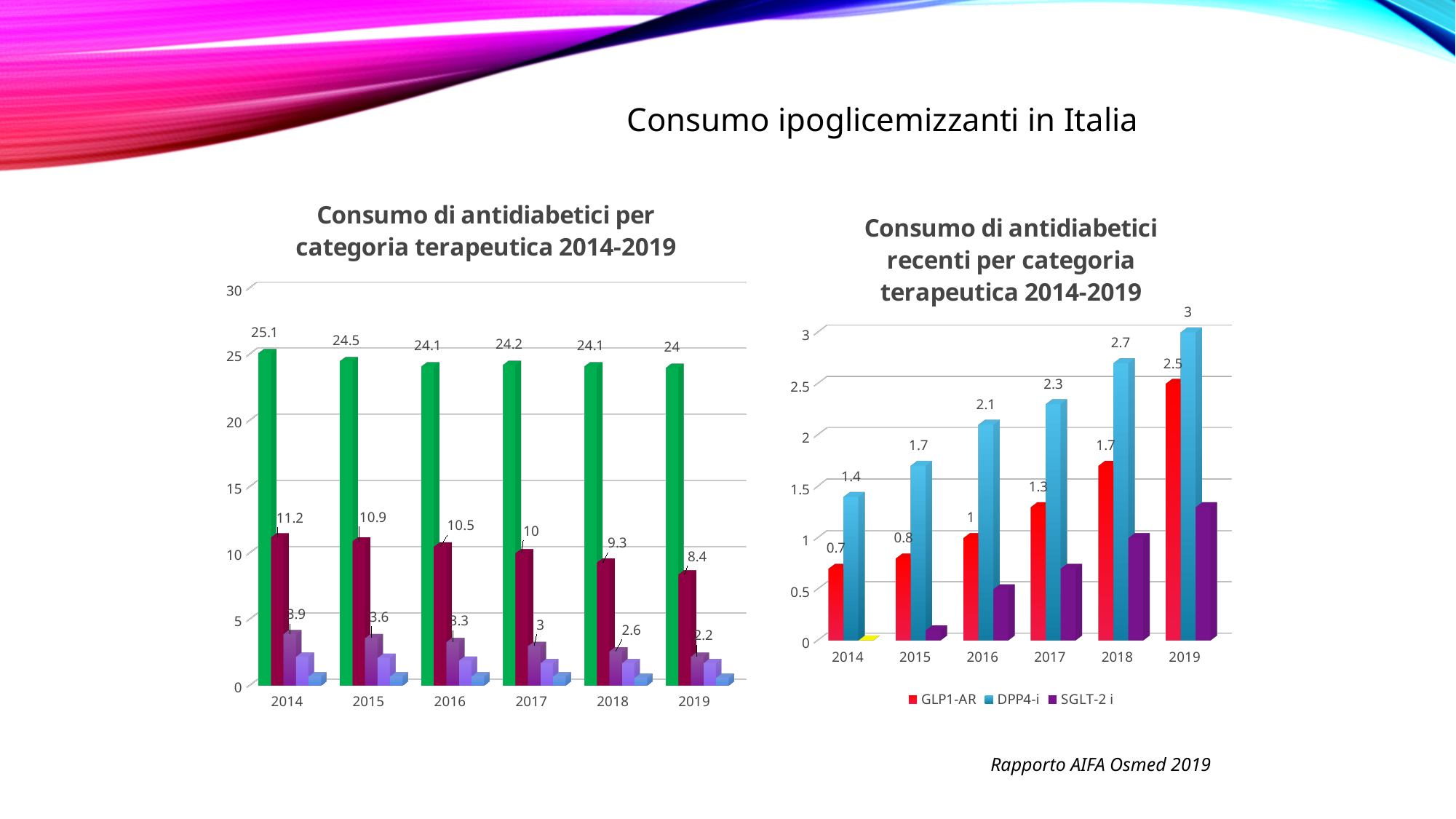
In the chart 'Consumo di antidiabetici recenti per categoria terapeutica 2014-2019', do the DPP4-i values rise or fall from 2014 to 2019? rise In the chart 'Consumo di antidiabetici per categoria terapeutica 2014-2019', what is the value of the dark red bar in 2019? 8.4 In the chart 'Consumo di antidiabetici per categoria terapeutica 2014-2019', what is the difference between the dark red bar values in 2014 and 2019? 2.8 What kind of chart is 'Consumo di antidiabetici per categoria terapeutica 2014-2019'? bar chart In the chart 'Consumo di antidiabetici recenti per categoria terapeutica 2014-2019', what is the value for DPP4-i in 2019? 3 In the chart 'Consumo di antidiabetici recenti per categoria terapeutica 2014-2019', what is the difference between the DPP4-i and GLP1-AR values in 2014? 0.7 In the chart 'Consumo di antidiabetici per categoria terapeutica 2014-2019', what is the value of the green bar in 2014? 25.1 In the chart 'Consumo di antidiabetici recenti per categoria terapeutica 2014-2019', how many series does the legend list? 3 In the chart 'Consumo di antidiabetici recenti per categoria terapeutica 2014-2019', what is the value for GLP1-AR in 2017? 1.3 In the chart 'Consumo di antidiabetici recenti per categoria terapeutica 2014-2019', is the SGLT-2 i value for 2019 greater or less than 1? greater In the chart 'Consumo di antidiabetici per categoria terapeutica 2014-2019', how many years are shown on the x axis? 6 In the chart 'Consumo di antidiabetici recenti per categoria terapeutica 2014-2019', in which year is the GLP1-AR value highest? 2019